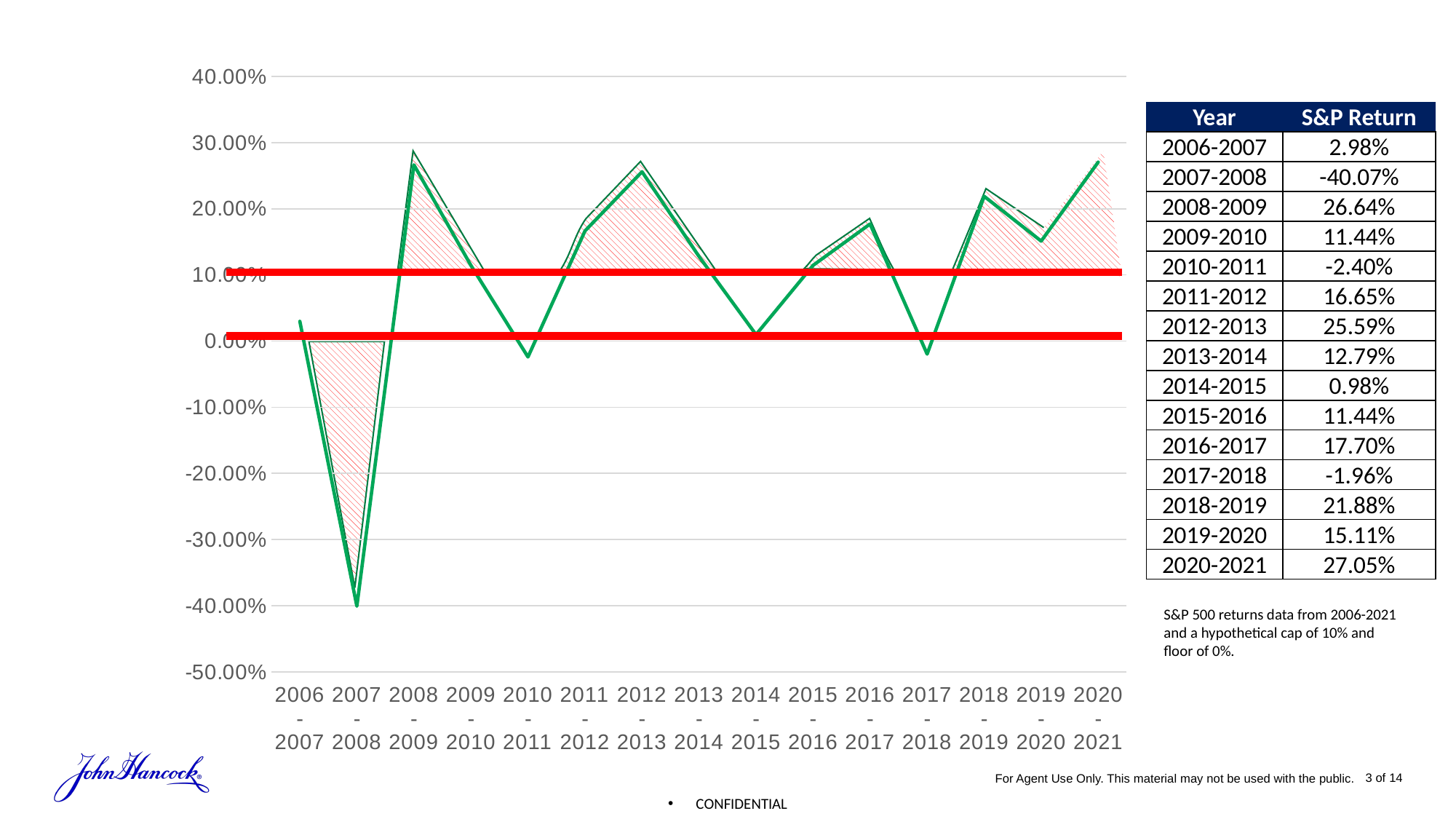
According to the table, what is the S&P return for 2020-2021? 27.05% What hypothetical cap and floor are described in the note next to the table? cap of 10% and floor of 0% Which year period has the highest S&P return? 2020-2021 Which year period has the lowest S&P return? 2007-2008 According to the table, what is the S&P return for 2014-2015? 0.98% What is the difference between the S&P return for 2008-2009 and for 2009-2010? 15.20% Which is larger, the S&P return for 2018-2019 or for 2019-2020? 2018-2019 How many year periods are plotted along the x axis of the chart? 15 Is the S&P return for 2012-2013 greater or less than 20.00%? greater Is the S&P return for 2010-2011 greater or less than 0.00%? less What kind of chart is shown on the slide? line chart According to the table, what is the S&P return for 2007-2008? -40.07%